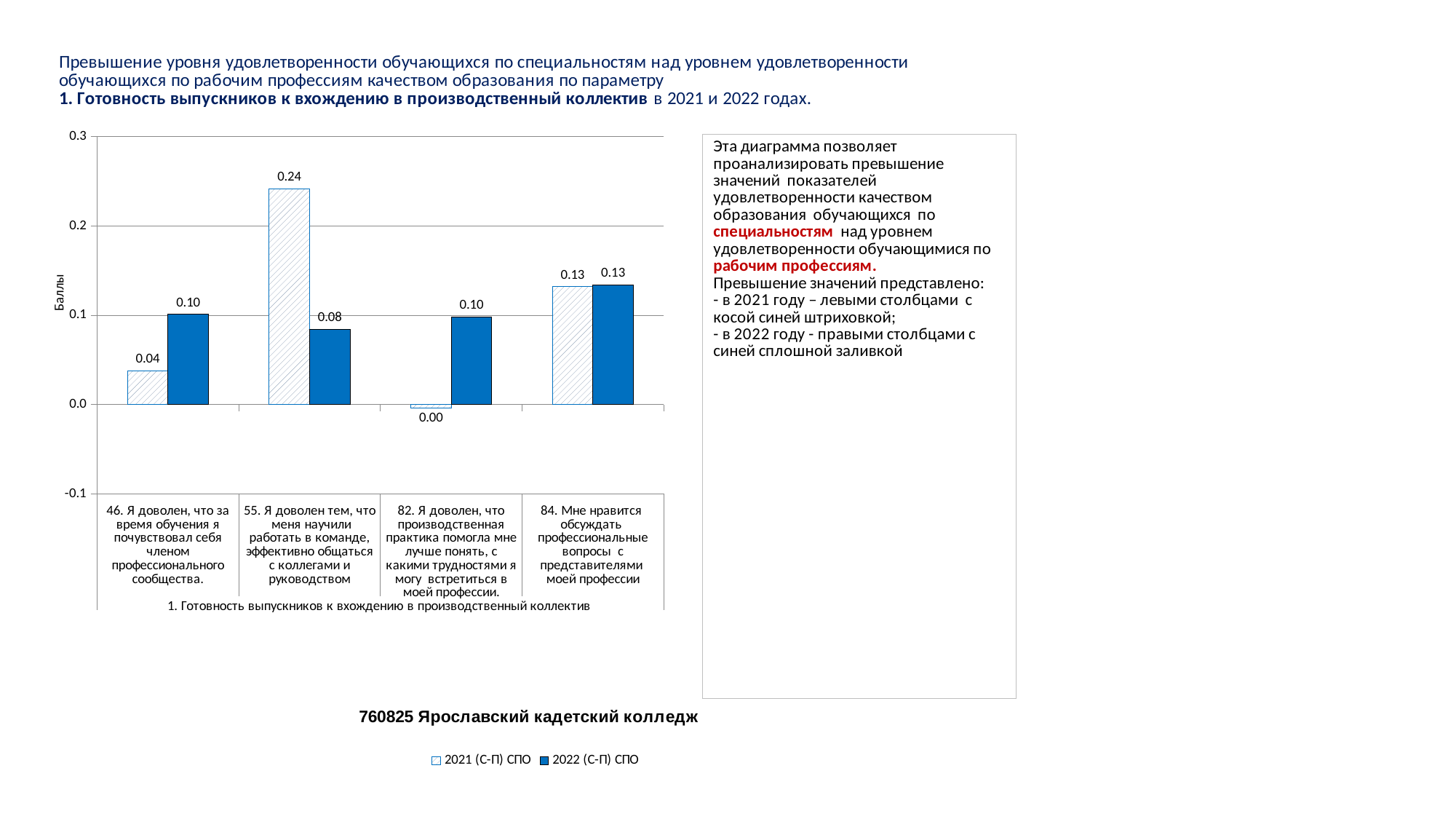
What is the value of the 2022 (С-П) СПО series for category 84 (Мне нравится обсуждать профессиональные вопросы)? 0.13 For category 46, which series has the larger value, 2021 (С-П) СПО or 2022 (С-П) СПО? 2022 (С-П) СПО What is the label of the y axis of the chart? Баллы Which category has the highest value in the 2021 (С-П) СПО series? 55. Я доволен тем, что меня научили работать в команде, эффективно общаться с коллегами и руководством What is the value of the 2022 (С-П) СПО series for category 46 (Я доволен, что за время обучения я почувствовал себя членом профессионального сообщества)? 0.10 How many series does the legend list? 2 What type of chart is shown on the slide? bar chart Which category has the lowest value in the 2022 (С-П) СПО series? 55. Я доволен тем, что меня научили работать в команде, эффективно общаться с коллегами и руководством What is the difference between the 2021 and 2022 values for category 55? 0.16 How many categories are shown on the x axis of the chart? 4 What is the value of the 2021 (С-П) СПО series for category 55 (Я доволен тем, что меня научили работать в команде)? 0.24 What is the value of the 2021 (С-П) СПО series for category 82 (производственная практика помогла мне лучше понять)? 0.00